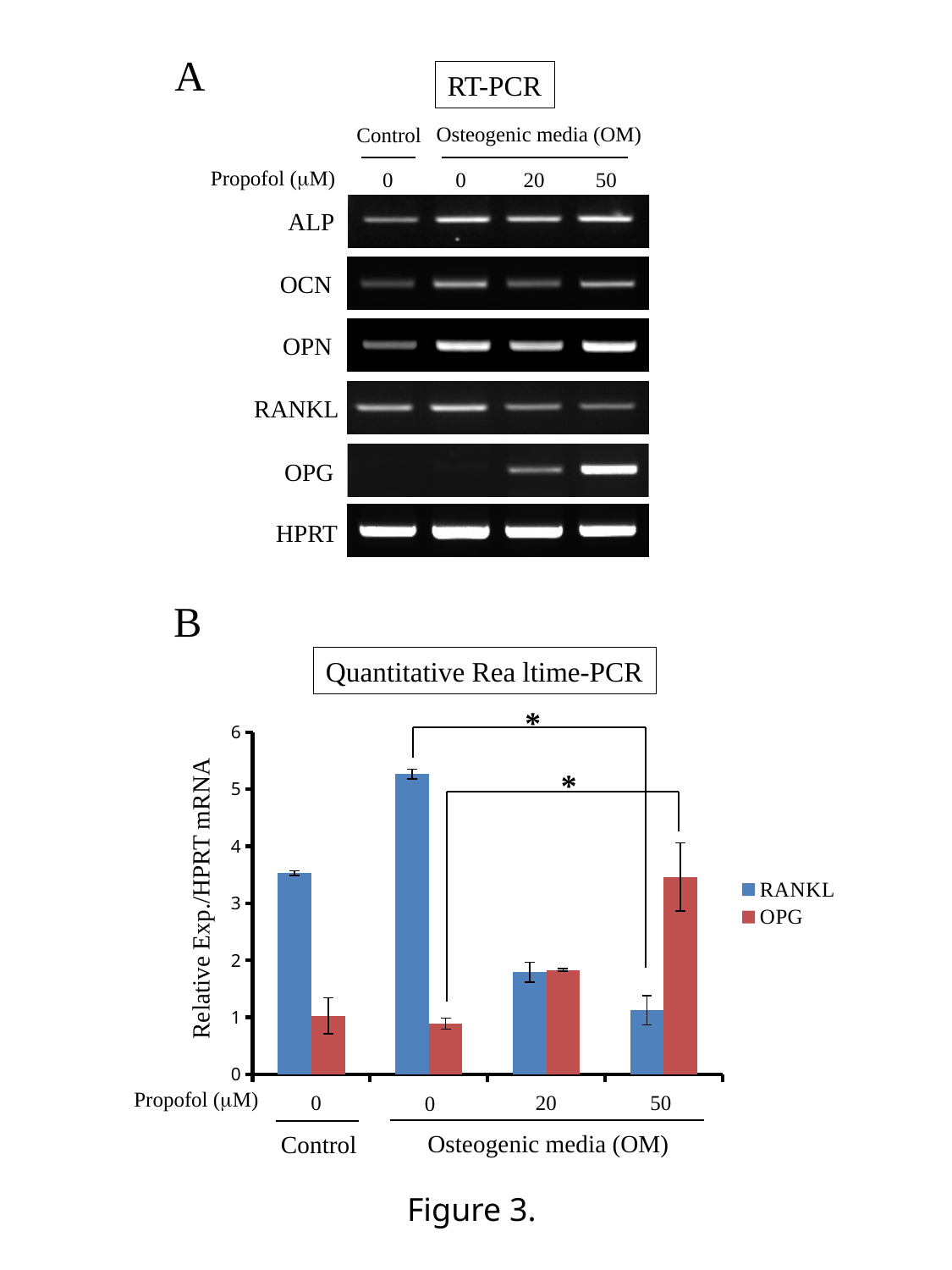
In the Quantitative Realtime-PCR chart, is the OPG value for Osteogenic media with 50 µM propofol greater or less than 3? greater In the Quantitative Realtime-PCR chart, is the RANKL value for Osteogenic media with 50 µM propofol greater or less than 2? less What type of chart is shown in panel B (Quantitative Realtime-PCR)? bar chart In the Quantitative Realtime-PCR chart, which treatment group has the highest OPG value? Osteogenic media (OM), propofol 50 µM In the Quantitative Realtime-PCR chart, which treatment group has the highest RANKL value? Osteogenic media (OM), propofol 0 µM In the Quantitative Realtime-PCR chart, which is larger for Osteogenic media with 50 µM propofol: RANKL or OPG? OPG In the Quantitative Realtime-PCR chart, which treatment group has the lowest RANKL value? Osteogenic media (OM), propofol 50 µM In the Quantitative Realtime-PCR chart, how many series does the legend list? 2 In the Quantitative Realtime-PCR chart, what is the label of the y axis? Relative Exp./HPRT mRNA In the Quantitative Realtime-PCR chart, is the RANKL value for Osteogenic media with 0 µM propofol greater or less than 5? greater In the Quantitative Realtime-PCR chart, which is larger in the Control group (0 µM propofol): RANKL or OPG? RANKL In the Quantitative Realtime-PCR chart, how many propofol treatment groups are plotted along the x axis? 4